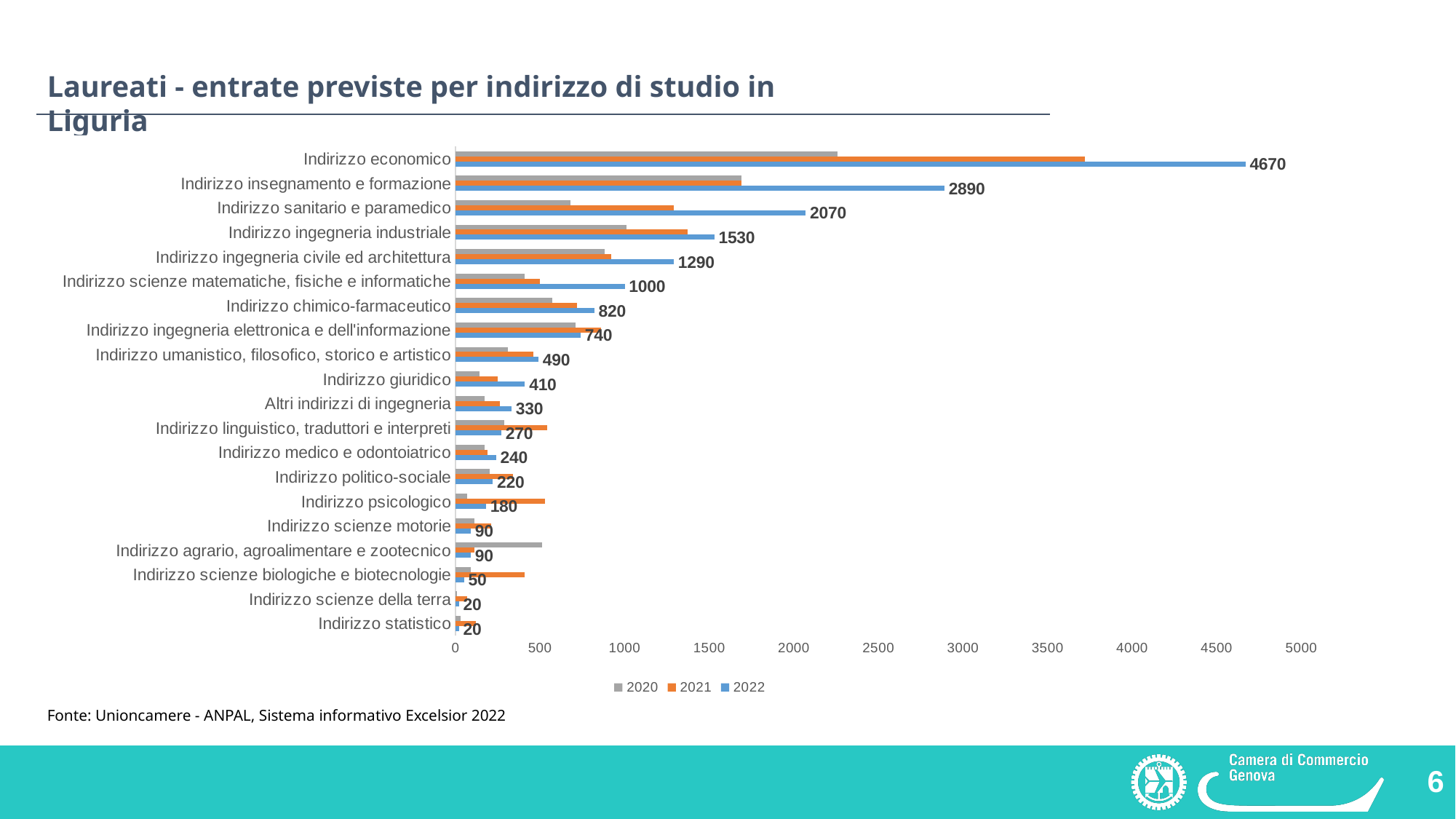
Which years are listed in the chart legend? 2020, 2021, 2022 What is the 2022 value for Indirizzo giuridico? 410 What kind of chart is shown on the slide? Bar chart Which study field has the highest 2022 value? Indirizzo economico Is the 2021 value for Indirizzo economico greater or less than 3500? greater How many study fields (categories) are shown on the chart? 20 What is the 2022 value for Indirizzo sanitario e paramedico? 2070 For Indirizzo psicologico, which bar is longer: 2021 or 2022? 2021 What is the 2022 value for Indirizzo economico? 4670 How many series does the legend list? 3 Is the 2020 value for Indirizzo insegnamento e formazione greater or less than 2000? less What is the difference between the 2022 values for Indirizzo economico and Indirizzo insegnamento e formazione? 1780